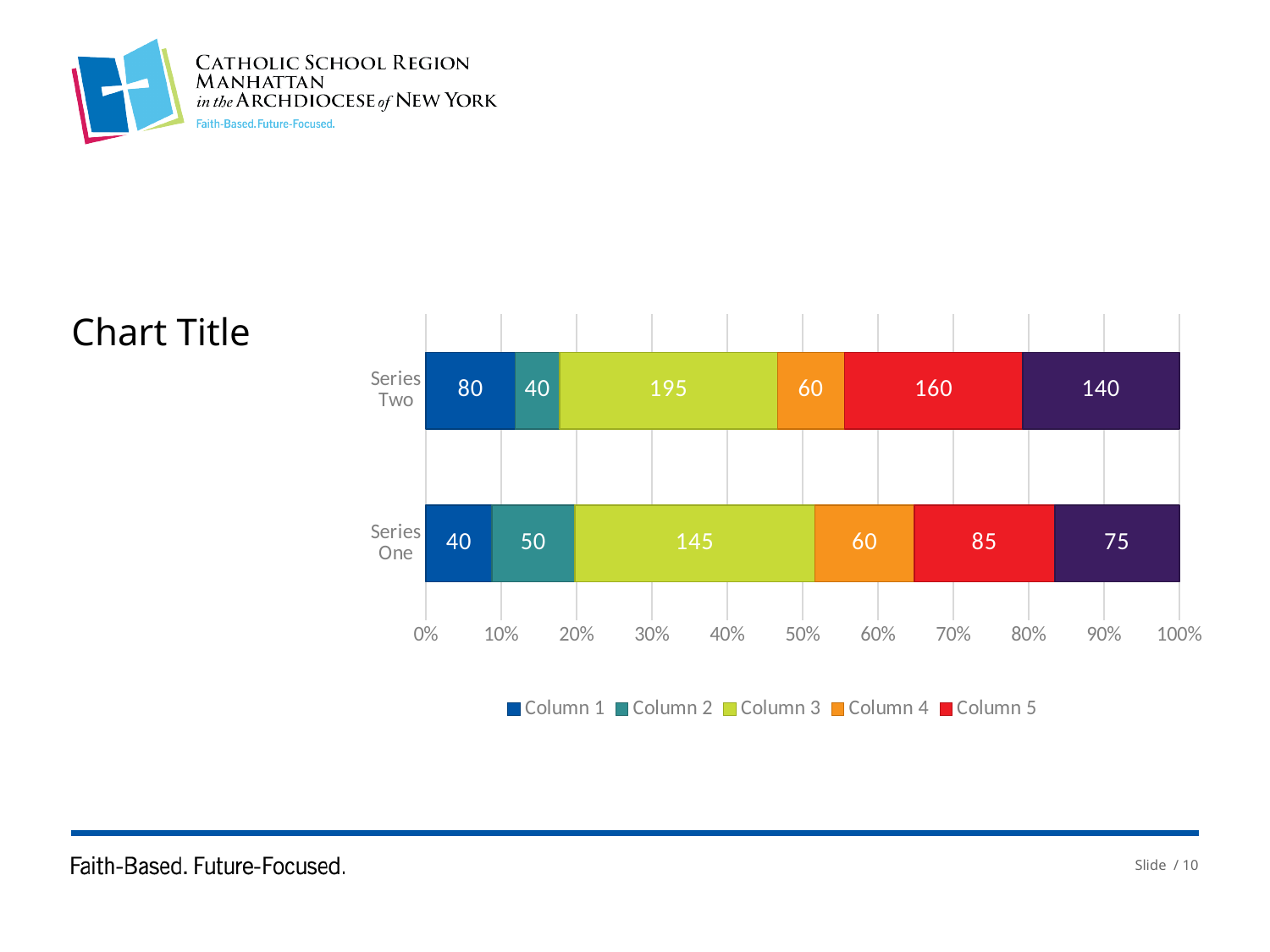
Within the Series One bar, which legend column has the largest value? Column 3 Which has the larger Column 2 value, Series One or Series Two? Series One What is the difference between the Column 3 values for Series Two and Series One? 50 What is the value of Column 1 for Series One? 40 What is the value of Column 5 for Series Two? 160 What is the total of all segments in the Series One bar? 455 How many entries does the legend list? 5 What is the value of Column 3 for Series Two? 195 What kind of chart is shown on the slide? Stacked bar chart What is the value of Column 4 for Series One? 60 How many bars (categories) are shown on the chart? 2 What is the total of all segments in the Series Two bar? 675